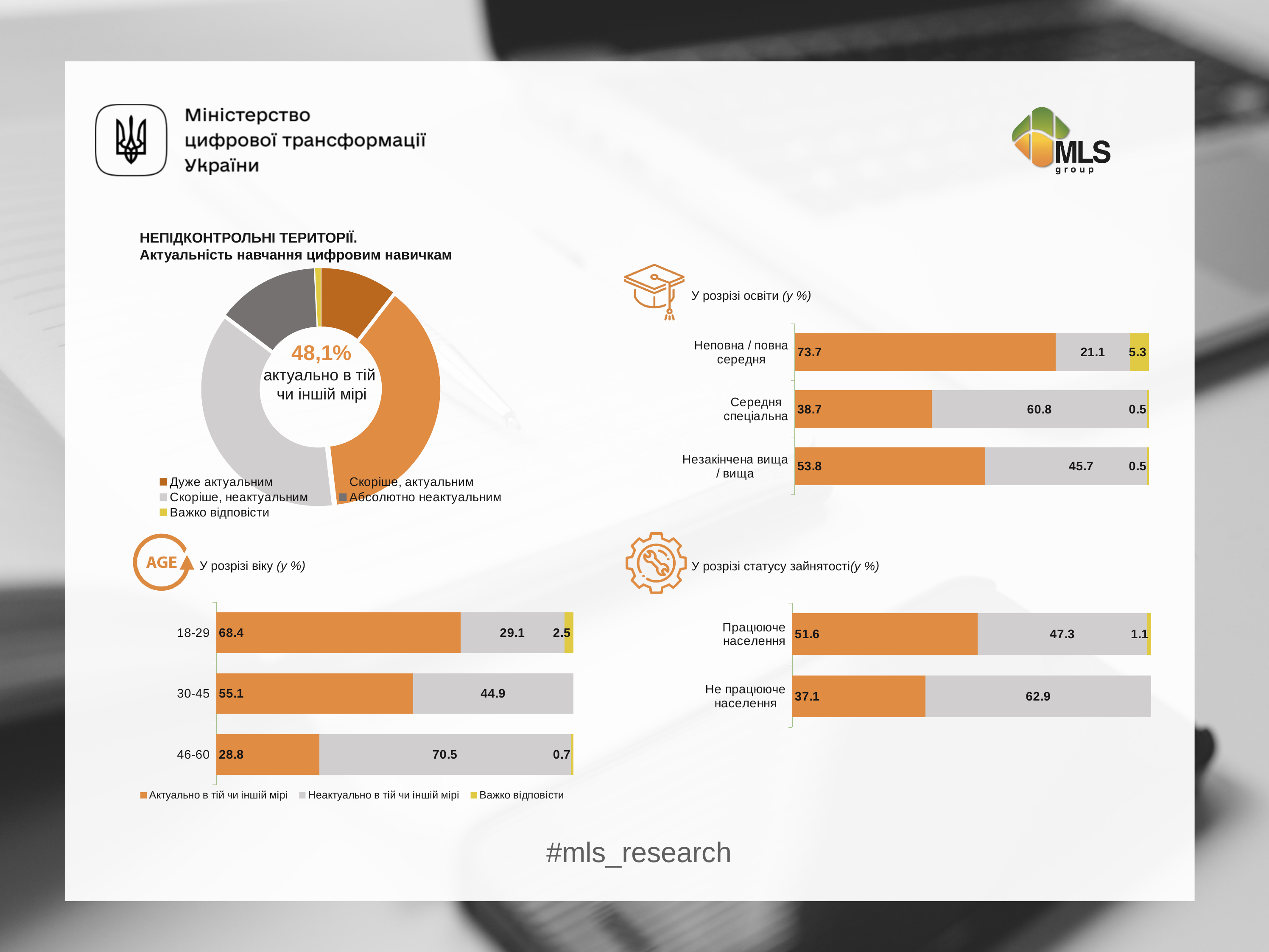
In the donut chart at the top left, how many entries does the legend list? 5 What kind of chart is the one titled 'НЕПІДКОНТРОЛЬНІ ТЕРИТОРІЇ. Актуальність навчання цифровим навичкам'? Donut chart In the chart 'У розрізі освіти', what is the value of 'Неактуально в тій чи іншій мірі' for 'Середня спеціальна'? 60.8 In the chart 'У розрізі освіти', which education category has the highest value for 'Актуально в тій чи іншій мірі'? Неповна / повна середня In the chart 'У розрізі статусу зайнятості', which group has the larger value for 'Актуально в тій чи іншій мірі': 'Працююче населення' or 'Не працююче населення'? Працююче населення In the chart 'У розрізі віку', what is the difference between the 'Актуально в тій чи іншій мірі' values for 18-29 and 30-45? 13.3 In the chart 'У розрізі віку', which age group has the lowest value for 'Актуально в тій чи іншій мірі'? 46-60 In the chart 'У розрізі статусу зайнятості', what is the value of 'Неактуально в тій чи іншій мірі' for 'Не працююче населення'? 62.9 In the chart 'У розрізі віку', how many series does the legend list? 3 In the chart 'У розрізі освіти', what is the value of 'Актуально в тій чи іншій мірі' for 'Неповна / повна середня'? 73.7 In the chart 'У розрізі віку', what is the value of 'Актуально в тій чи іншій мірі' for the 46-60 age group? 28.8 In the chart 'У розрізі віку', how many age groups are shown? 3